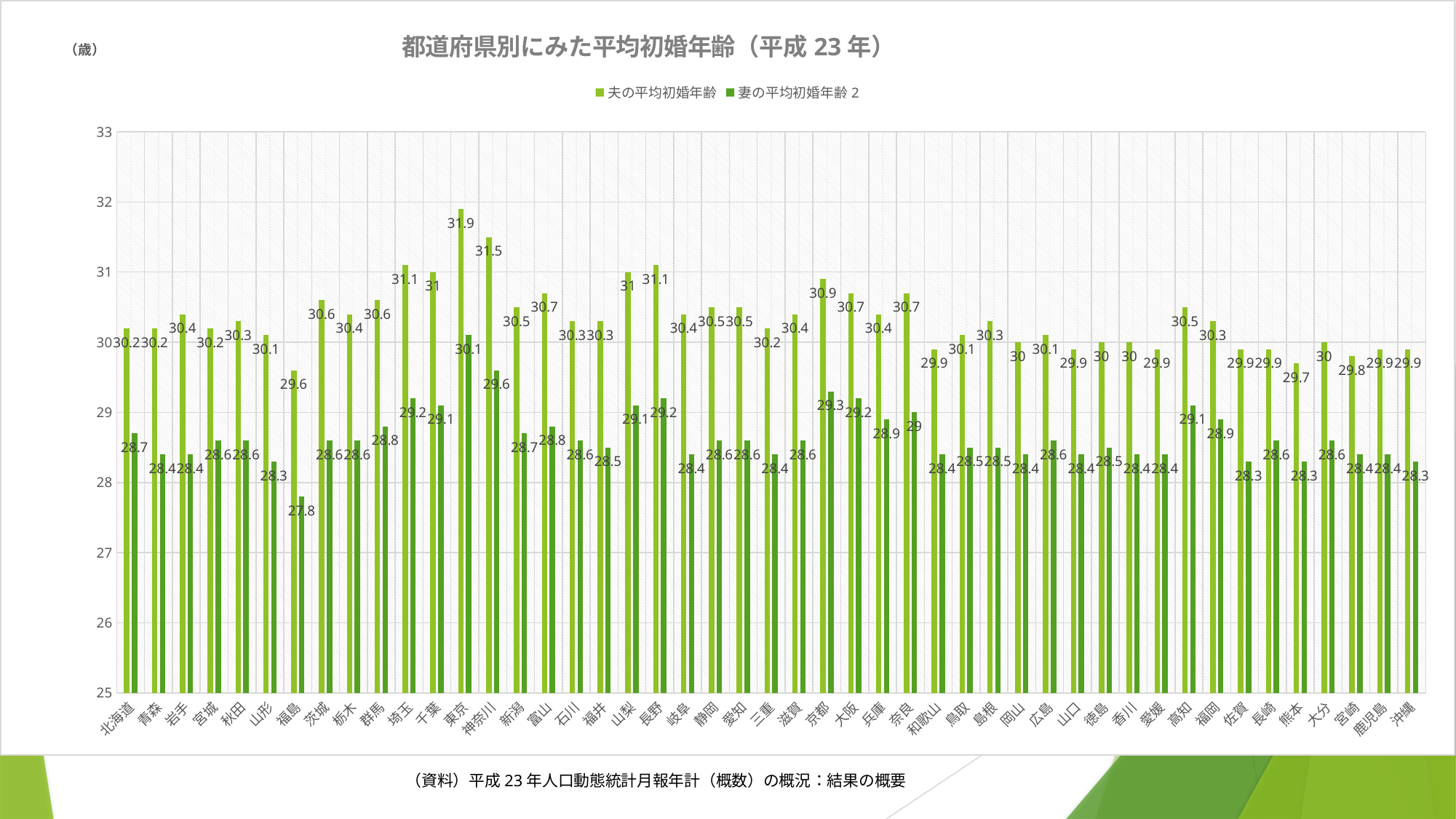
How many series does the legend list? 2 Which prefecture has the lowest 妻の平均初婚年齢? 福島 What is the value of 夫の平均初婚年齢 for 東京? 31.9 What kind of chart is shown on the slide? bar chart What is the value of 妻の平均初婚年齢 for 福島? 27.8 What is the title of the chart? 都道府県別にみた平均初婚年齢（平成23年） How many prefectures (categories) are plotted on the x axis? 47 Is the value of 夫の平均初婚年齢 for 東京 greater or less than 31? greater Which is larger, 夫の平均初婚年齢 for 埼玉 or for 京都? 埼玉 What is the difference between 夫の平均初婚年齢 and 妻の平均初婚年齢 for 東京? 1.8 What is the value of 夫の平均初婚年齢 for 神奈川? 31.5 Which prefecture has the highest 夫の平均初婚年齢? 東京